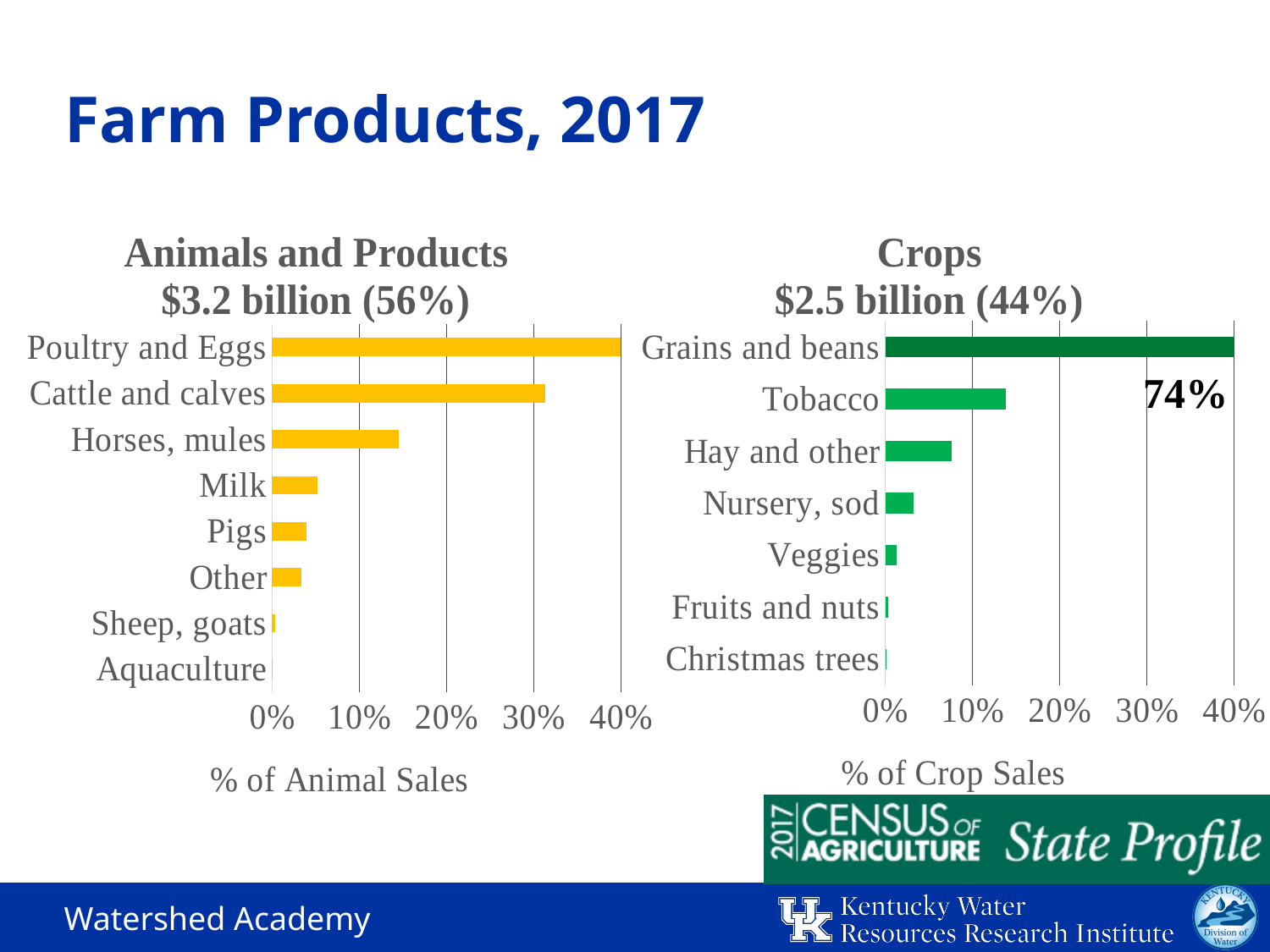
In the 'Animals and Products' chart, is the value for Cattle and calves greater or less than 20%? greater What is the x-axis label of the 'Crops' chart? % of Crop Sales In the 'Animals and Products' chart, which category has the highest share of animal sales? Poultry and Eggs In the 'Crops' chart, which category has the highest share of crop sales? Grains and beans In the 'Crops' chart, how many categories are plotted? 7 In the 'Crops' chart, which category has the lowest share of crop sales? Christmas trees In the 'Crops' chart, which is larger, Hay and other or Nursery, sod? Hay and other What kind of chart is the 'Crops' chart on the right? bar chart In the 'Animals and Products' chart, how many categories are plotted? 8 In the 'Crops' chart, is the value for Tobacco greater or less than 20%? less In the 'Animals and Products' chart, which category has the lowest share of animal sales? Aquaculture What kind of chart is the 'Animals and Products' chart on the left? bar chart